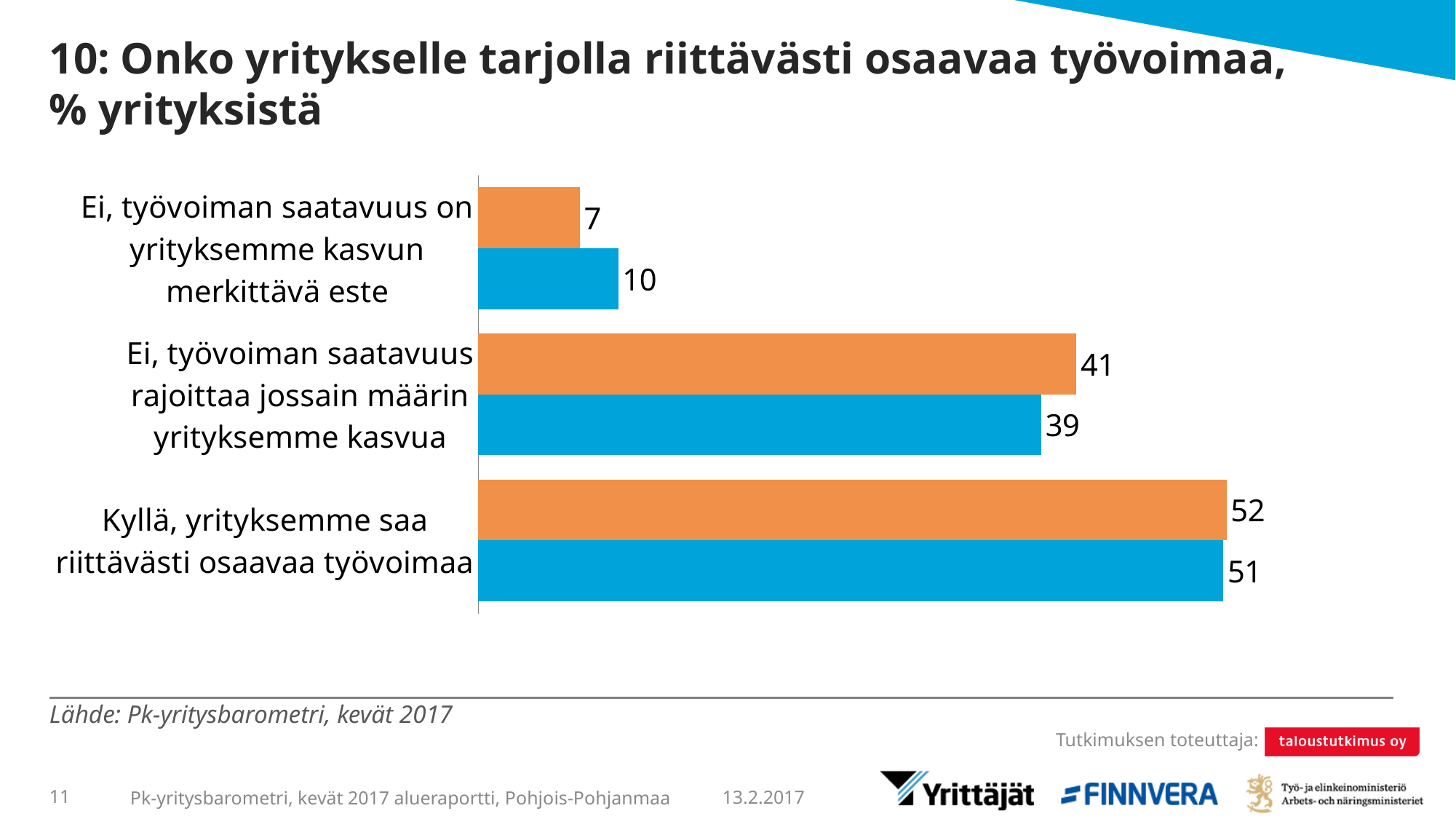
What is the value of the orange bar for "Kyllä, yrityksemme saa riittävästi osaavaa työvoimaa"? 52 How many categories are shown on the chart? 3 What is the value of the orange bar for "Ei, työvoiman saatavuus rajoittaa jossain määrin yrityksemme kasvua"? 41 What kind of chart is shown on the slide? bar chart What is the source cited below the chart? Pk-yritysbarometri, kevät 2017 Which category has the highest orange bar value? Kyllä, yrityksemme saa riittävästi osaavaa työvoimaa Which category has the lowest blue bar value? Ei, työvoiman saatavuus on yrityksemme kasvun merkittävä este What is the difference between the orange and blue bar values for "Ei, työvoiman saatavuus rajoittaa jossain määrin yrityksemme kasvua"? 2 What is the value of the blue bar for "Kyllä, yrityksemme saa riittävästi osaavaa työvoimaa"? 51 What is the value of the blue bar for "Ei, työvoiman saatavuus on yrityksemme kasvun merkittävä este"? 10 For "Ei, työvoiman saatavuus on yrityksemme kasvun merkittävä este", which bar is larger, the orange or the blue? blue What is the difference between the orange and blue bar values for "Ei, työvoiman saatavuus on yrityksemme kasvun merkittävä este"? 3